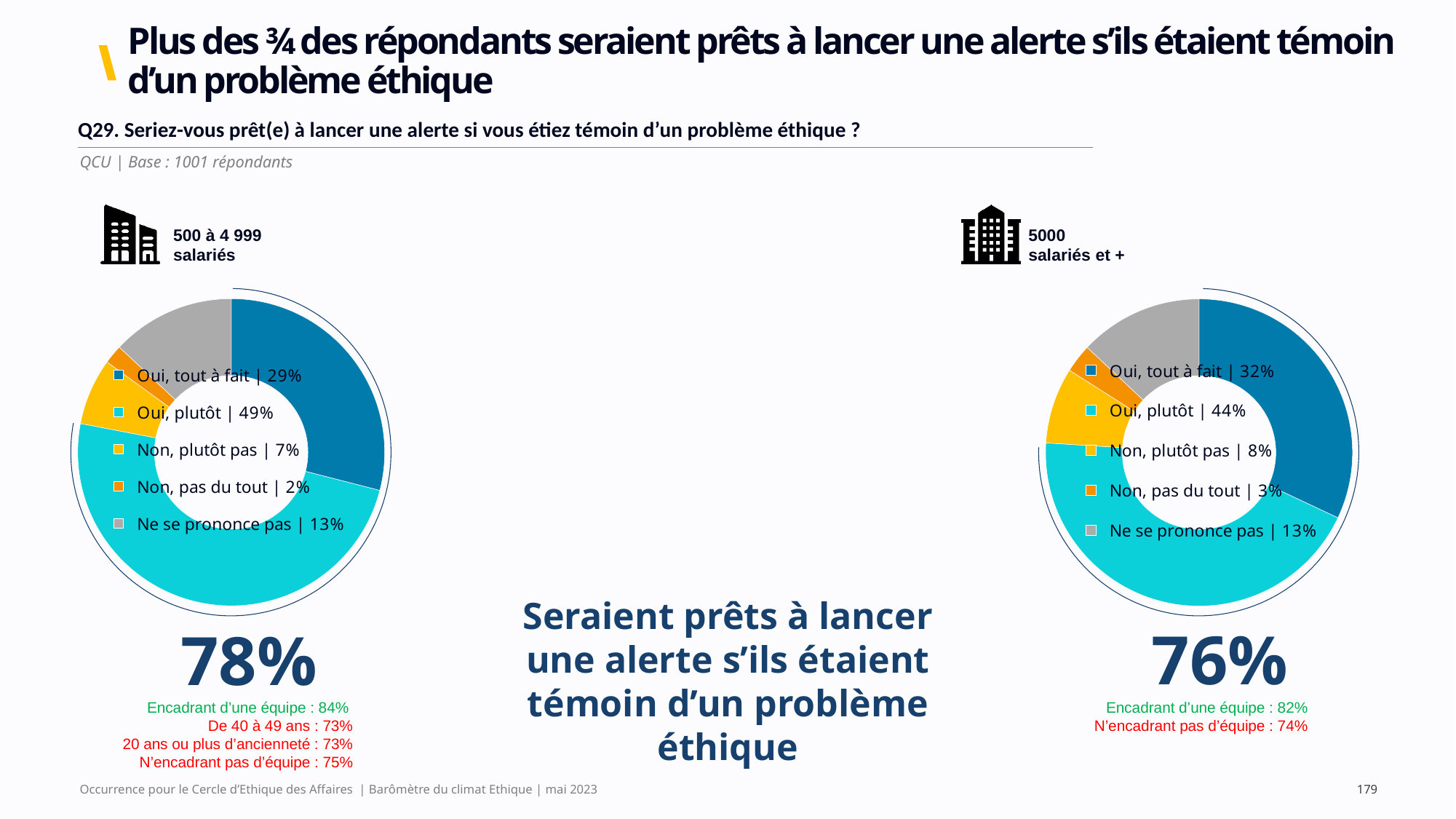
What colour represents "Ne se prononce pas" in both charts? Grey In the right chart (5000 salariés et +), what is the value for "Ne se prononce pas"? 13% In the left chart (500 à 4 999 salariés), which category has the highest value? Oui, plutôt Which chart has the higher value for "Oui, tout à fait": the left (500 à 4 999 salariés) or the right (5000 salariés et +)? Right (5000 salariés et +) In the right chart (5000 salariés et +), what is the value for "Oui, tout à fait"? 32% How many categories does the left chart (500 à 4 999 salariés) show? 5 In the left chart (500 à 4 999 salariés), what is the combined share of "Oui, tout à fait" and "Oui, plutôt"? 78% In the left chart (500 à 4 999 salariés), what is the value for "Oui, plutôt"? 49% What kind of chart is used on the right (5000 salariés et +)? Pie chart (donut) In the right chart (5000 salariés et +), which category has the lowest value? Non, pas du tout In the right chart (5000 salariés et +), which is larger: "Non, plutôt pas" or "Non, pas du tout"? Non, plutôt pas In the left chart (500 à 4 999 salariés), what is the difference between "Oui, plutôt" and "Oui, tout à fait"? 20 percentage points